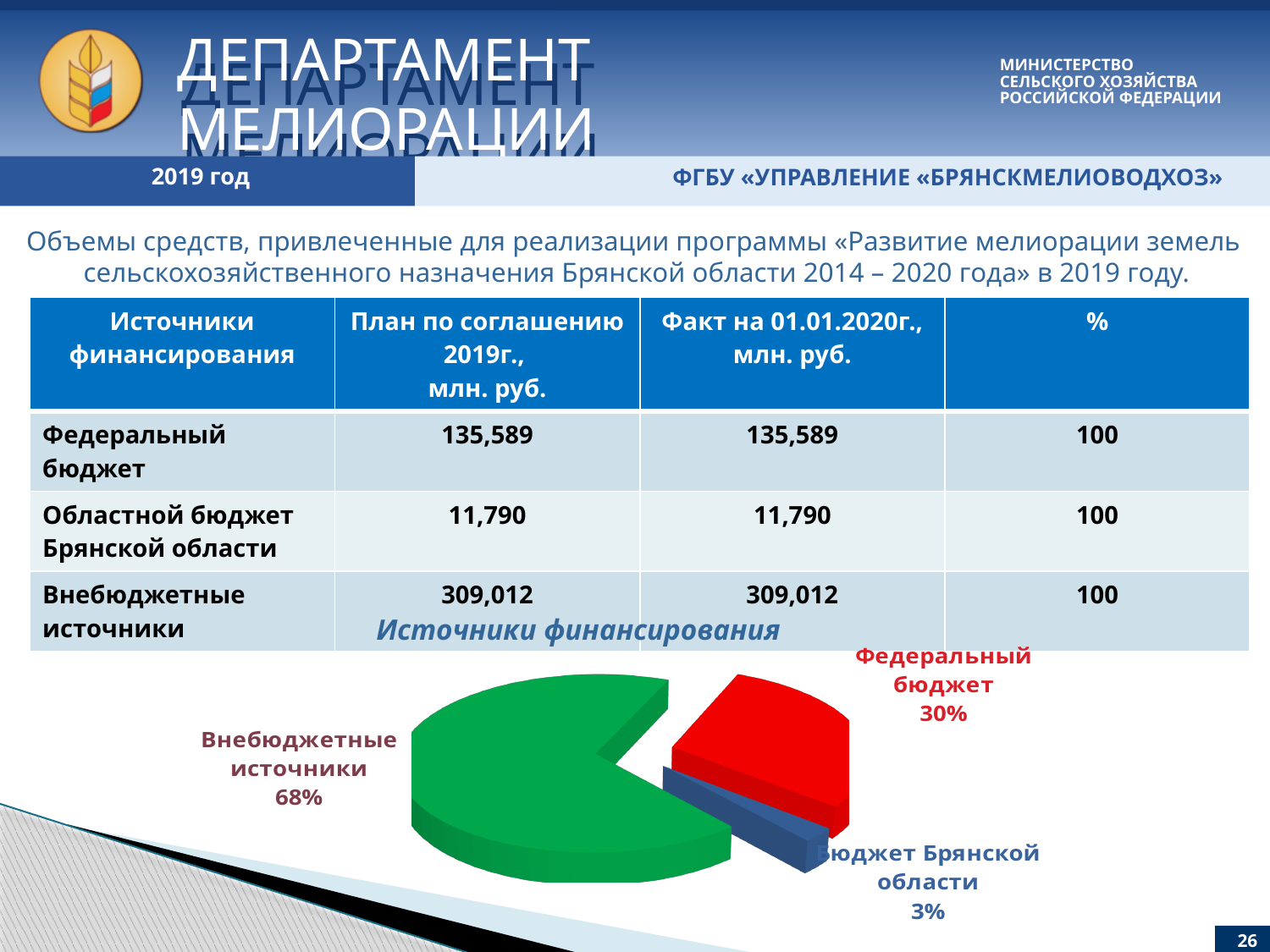
What kind of chart is shown under the title «Источники финансирования»? pie chart In the pie chart, which is larger: «Федеральный бюджет» or «Бюджет Брянской области»? Федеральный бюджет What share of the pie chart does «Внебюджетные источники» hold? 68% How many slices does the pie chart have? 3 In the pie chart, what is the difference in percentage points between «Внебюджетные источники» and «Федеральный бюджет»? 38 Which slice of the pie chart is the largest? Внебюджетные источники What is the title of the pie chart? Источники финансирования What colour is the «Внебюджетные источники» slice in the pie chart? green Which slice of the pie chart is the smallest? Бюджет Брянской области In the pie chart, what is the difference in percentage points between «Федеральный бюджет» and «Бюджет Брянской области»? 27 What share of the pie chart does «Федеральный бюджет» hold? 30% What share of the pie chart does «Бюджет Брянской области» hold? 3%